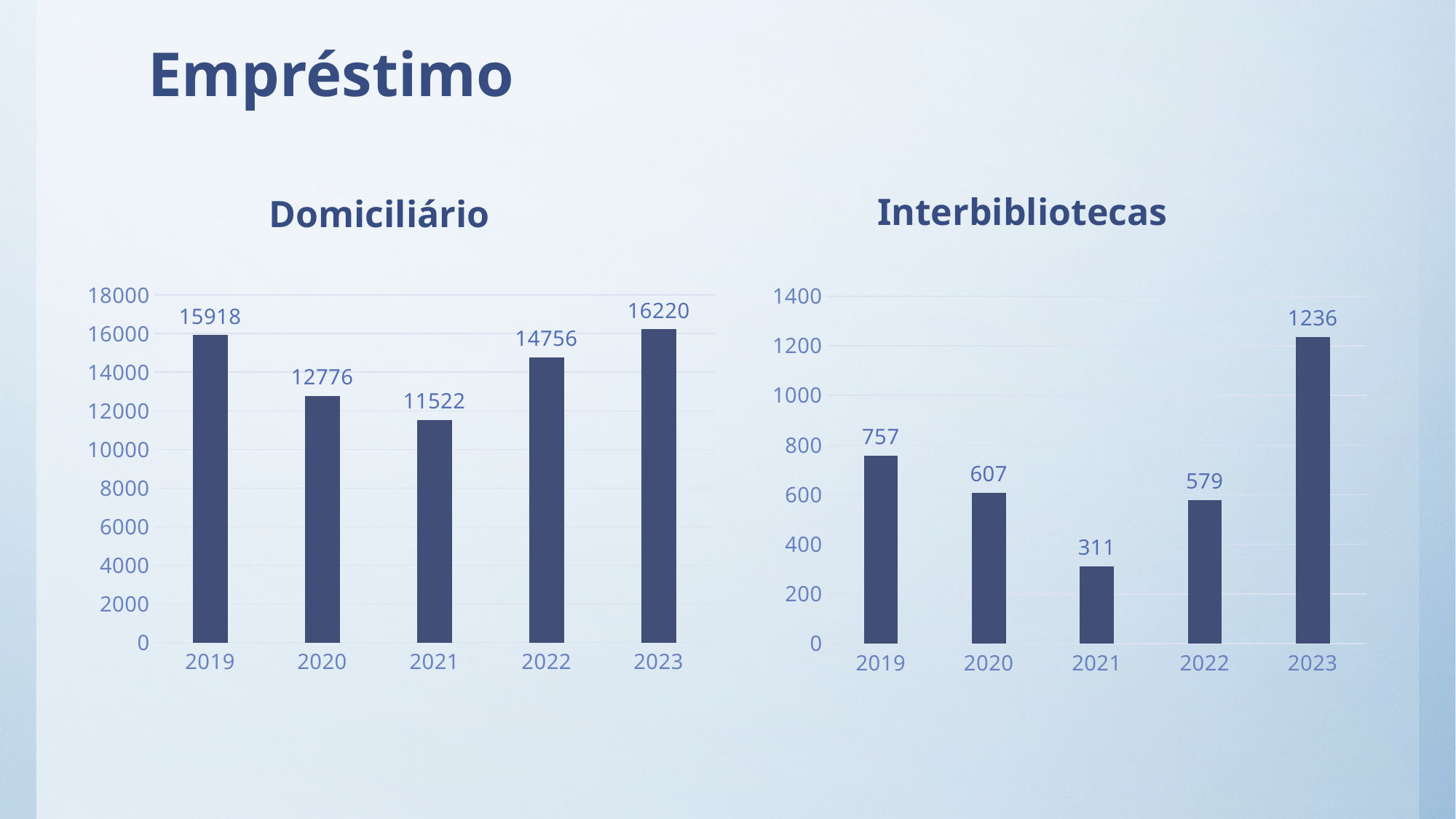
In the Domiciliário chart, which is larger, the value for 2020 or the value for 2022? 2022 How many years are shown on the x axis of the Domiciliário chart? 5 What is the title of the chart on the right side of the slide? Interbibliotecas In the Domiciliário chart, which year has the highest value? 2023 In the Domiciliário chart, what is the difference between the values for 2023 and 2019? 302 In the Interbibliotecas chart, what is the difference between the values for 2019 and 2020? 150 In the Interbibliotecas chart, what is the value for 2022? 579 In the Interbibliotecas chart, is the value for 2023 greater or less than 1200? greater In the Domiciliário chart, do the values rise or fall from 2021 to 2023? rise In the Interbibliotecas chart, which year has the lowest value? 2021 In the Domiciliário chart, what is the value for 2021? 11522 What kind of chart is the Interbibliotecas chart? bar chart